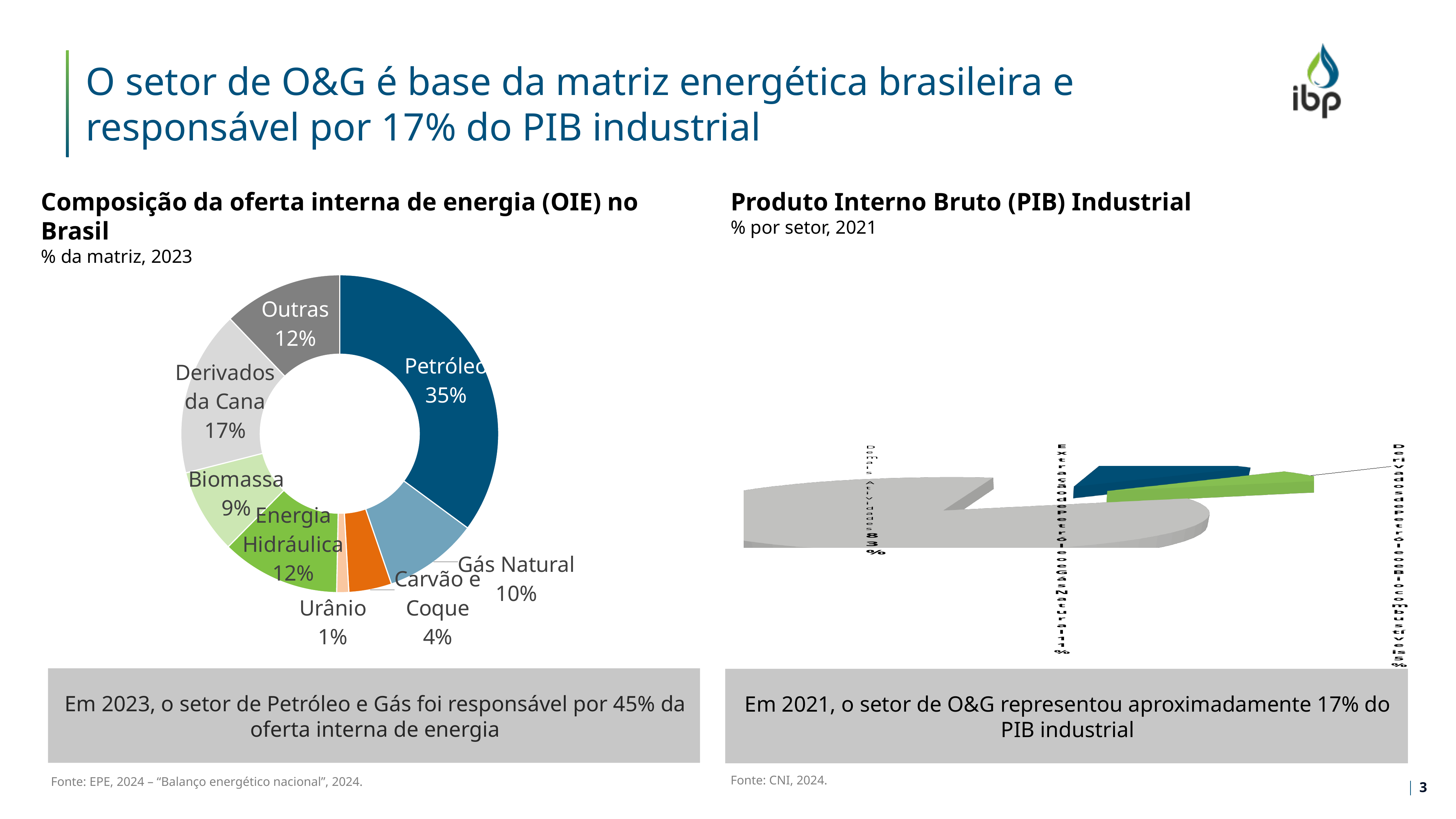
In the chart 'Composição da oferta interna de energia (OIE) no Brasil', what is the value for Carvão e Coque? 4% How many categories are shown in the chart 'Composição da oferta interna de energia (OIE) no Brasil'? 8 In the chart 'Composição da oferta interna de energia (OIE) no Brasil', what is the value for Gás Natural? 10% In the chart 'Composição da oferta interna de energia (OIE) no Brasil', which category has the largest share? Petróleo What year does the chart 'Composição da oferta interna de energia (OIE) no Brasil' refer to, according to its subtitle? 2023 In the chart 'Composição da oferta interna de energia (OIE) no Brasil', which is larger: Biomassa or Energia Hidráulica? Energia Hidráulica In the chart 'Composição da oferta interna de energia (OIE) no Brasil', what share does Petróleo have? 35% In the chart 'Composição da oferta interna de energia (OIE) no Brasil', which category has the smallest share? Urânio In the chart 'Composição da oferta interna de energia (OIE) no Brasil', what is the value for Derivados da Cana? 17% In the chart 'Composição da oferta interna de energia (OIE) no Brasil', what is the difference between the shares of Petróleo and Gás Natural? 25% In the chart 'Composição da oferta interna de energia (OIE) no Brasil', what is the combined share of Petróleo and Gás Natural? 45% What kind of chart is 'Composição da oferta interna de energia (OIE) no Brasil'? Doughnut chart